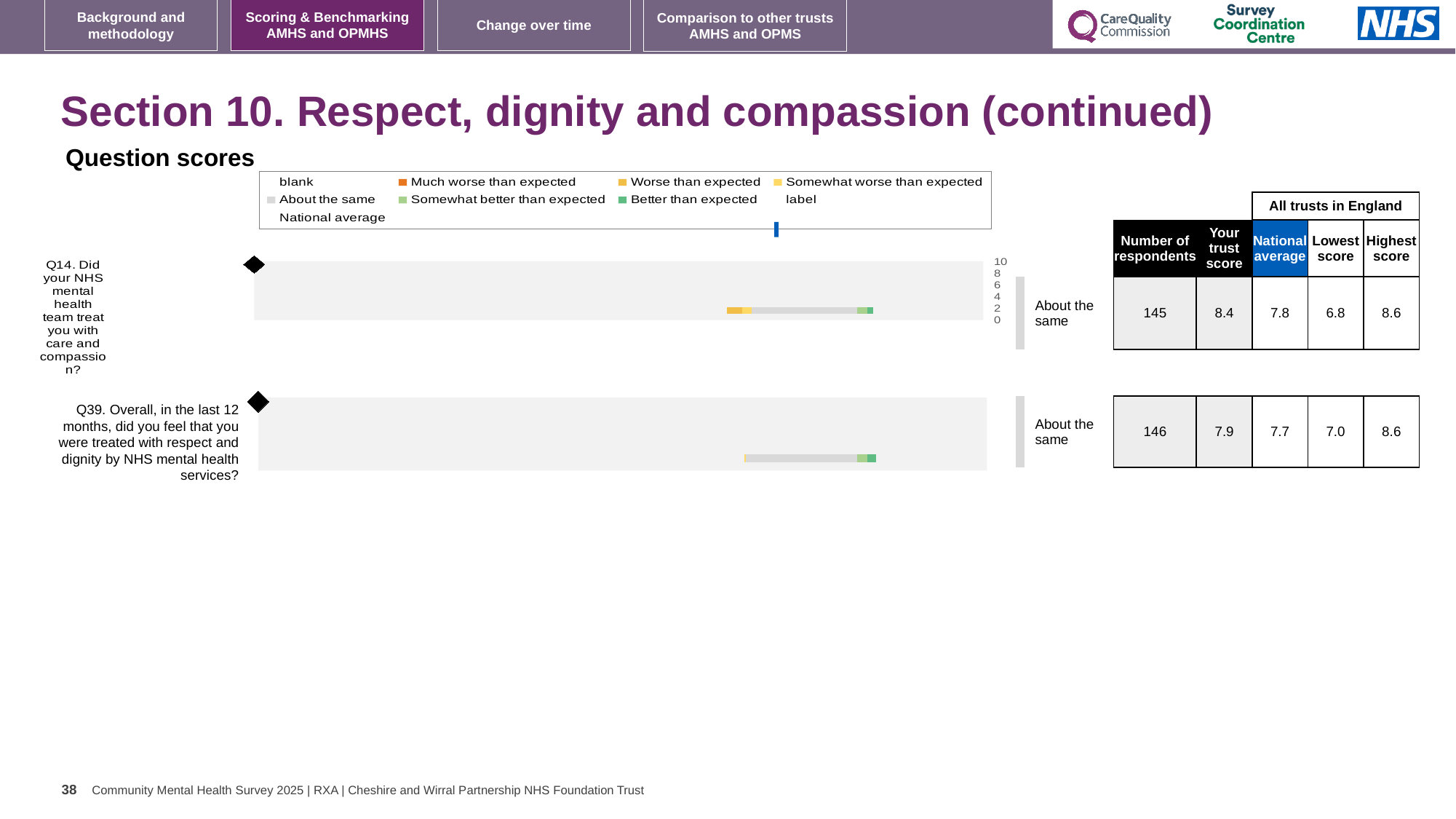
How many questions are plotted in the chart? 2 What benchmark category is shown for Q14? About the same What is the difference between the highest and lowest scores for Q39? 1.6 What is the national average for Q39 (treated with respect and dignity)? 7.7 What kind of chart is used to show the question scores? Bar chart What is the trust score for Q14 (care and compassion)? 8.4 What is the lowest score among all trusts in England for Q14? 6.8 How many respondents answered Q39? 146 What colour does the legend use for 'Much worse than expected'? Orange What is the highest score among all trusts in England for Q39? 8.6 What is the difference between the trust score and the national average for Q14? 0.6 Which question has the higher trust score, Q14 or Q39? Q14